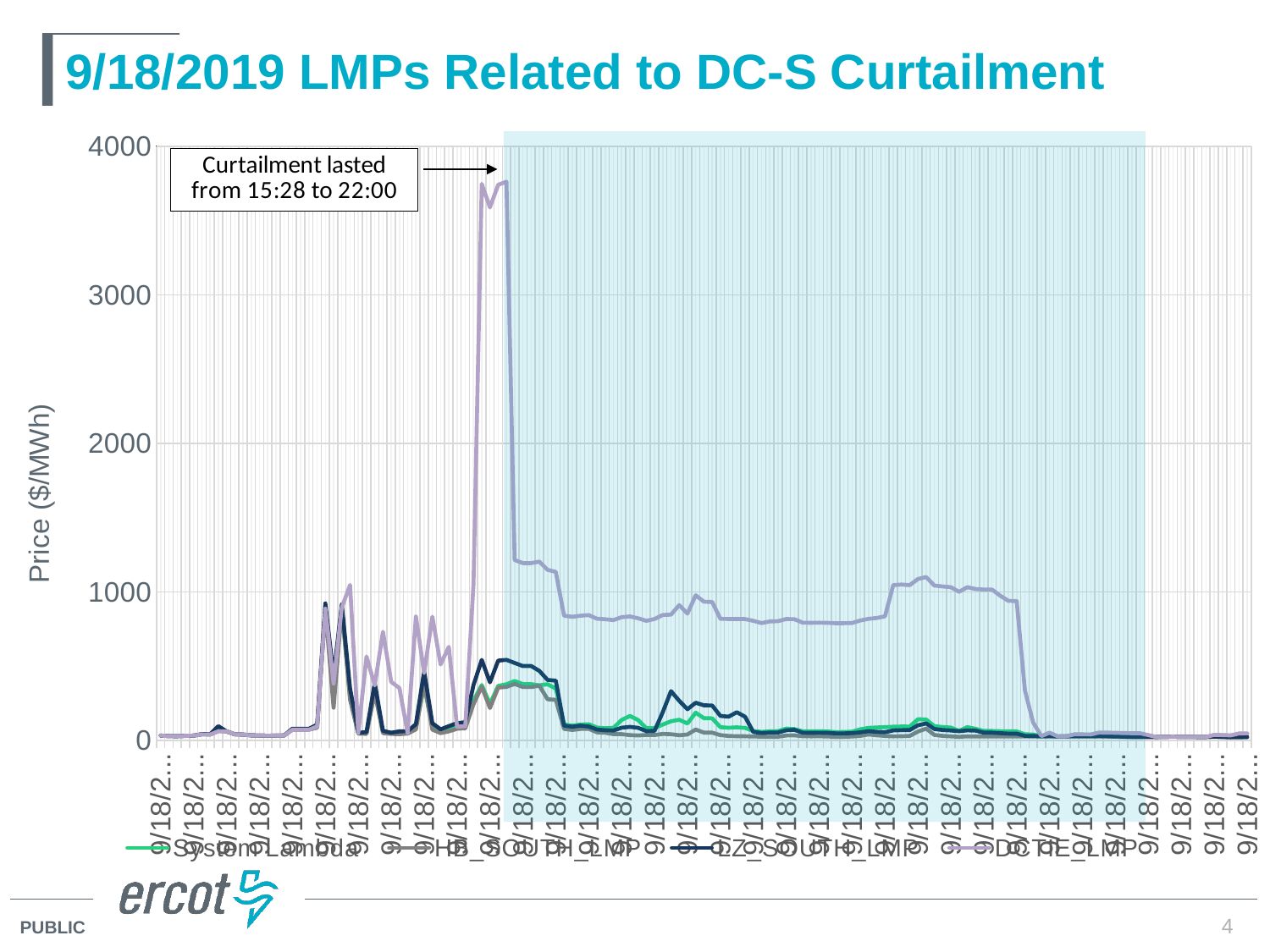
Which series has the higher peak, DC_TIE_LMP or HB_SOUTH_LMP? DC_TIE_LMP What is the highest tick value shown on the y axis? 4000 What is the label of the y axis? Price ($/MWh) Which series reaches the highest price on the chart? DCTIE_LMP What is the title of the chart? 9/18/2019 LMPs Related to DC-S Curtailment What kind of chart is shown on the slide? Line chart Is the peak value of the DC_TIE_LMP series greater or less than 3000? greater Is the peak value of the LZ_SOUTH_LMP series greater or less than 2000? less How many series does the legend list? 4 Does the DC_TIE_LMP series rise or fall immediately after its peak near the start of the shaded region? fall